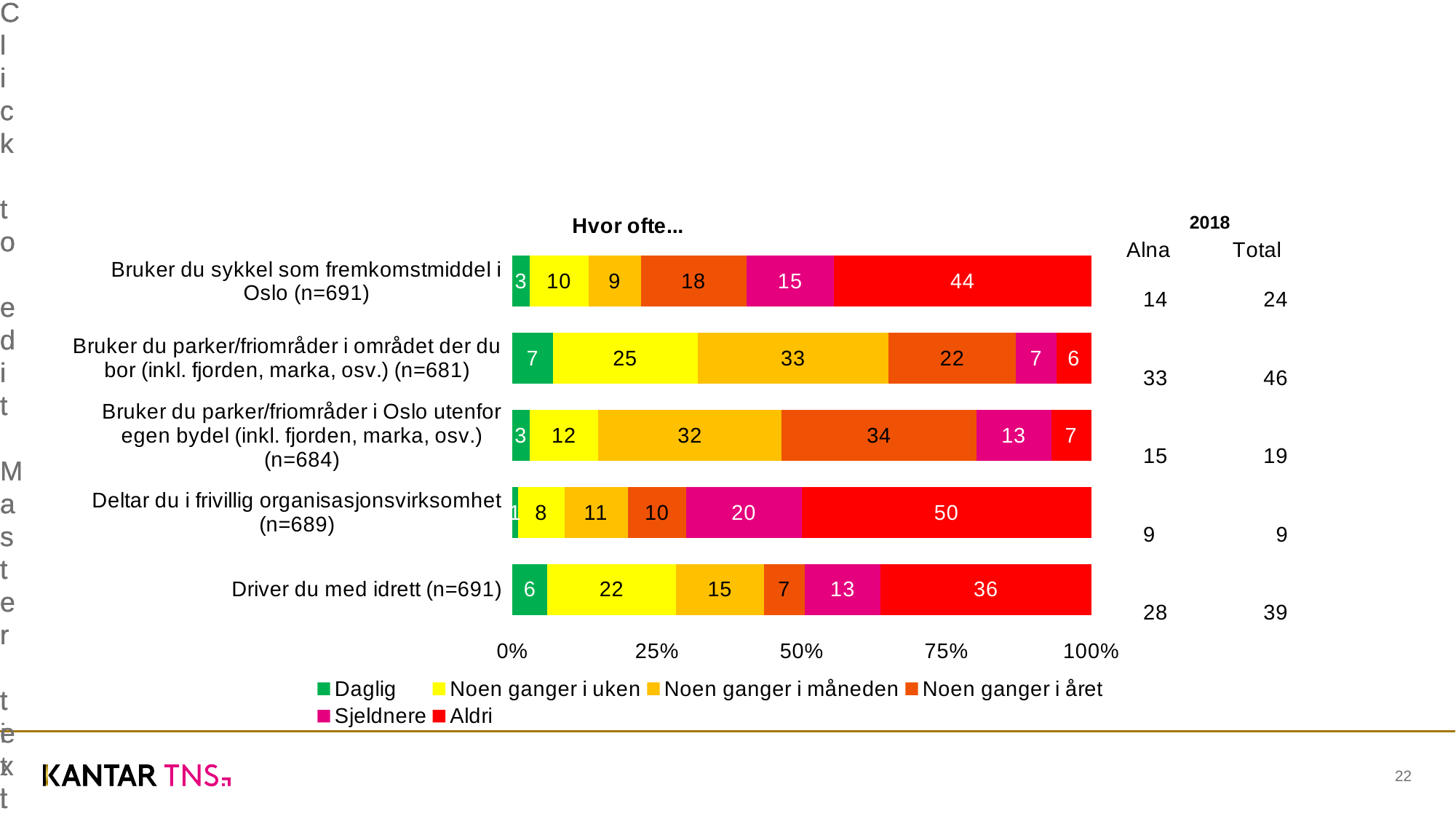
What kind of chart is shown on the slide? Stacked bar chart How many categories (questions) are shown on the chart? 5 What is the difference between the "Aldri" values for "Deltar du i frivillig organisasjonsvirksomhet (n=689)" and "Driver du med idrett (n=691)"? 14 Which category has the lowest value for "Daglig"? Deltar du i frivillig organisasjonsvirksomhet (n=689) What is the value for "Aldri" for "Bruker du sykkel som fremkomstmiddel i Oslo (n=691)"? 44 What is the value for "Daglig" for "Driver du med idrett (n=691)"? 6 How many series does the legend list? 6 Which is larger: the "Noen ganger i uken" value for "Bruker du parker/friområder i området der du bor (inkl. fjorden, marka, osv.) (n=681)" or for "Driver du med idrett (n=691)"? Bruker du parker/friområder i området der du bor (inkl. fjorden, marka, osv.) (n=681) What is the value for "Noen ganger i året" for "Bruker du parker/friområder i Oslo utenfor egen bydel (inkl. fjorden, marka, osv.) (n=684)"? 34 What is the title of the chart? Hvor ofte... Which category has the highest value for "Aldri"? Deltar du i frivillig organisasjonsvirksomhet (n=689) What is the value for "Noen ganger i måneden" for "Bruker du parker/friområder i området der du bor (inkl. fjorden, marka, osv.) (n=681)"? 33